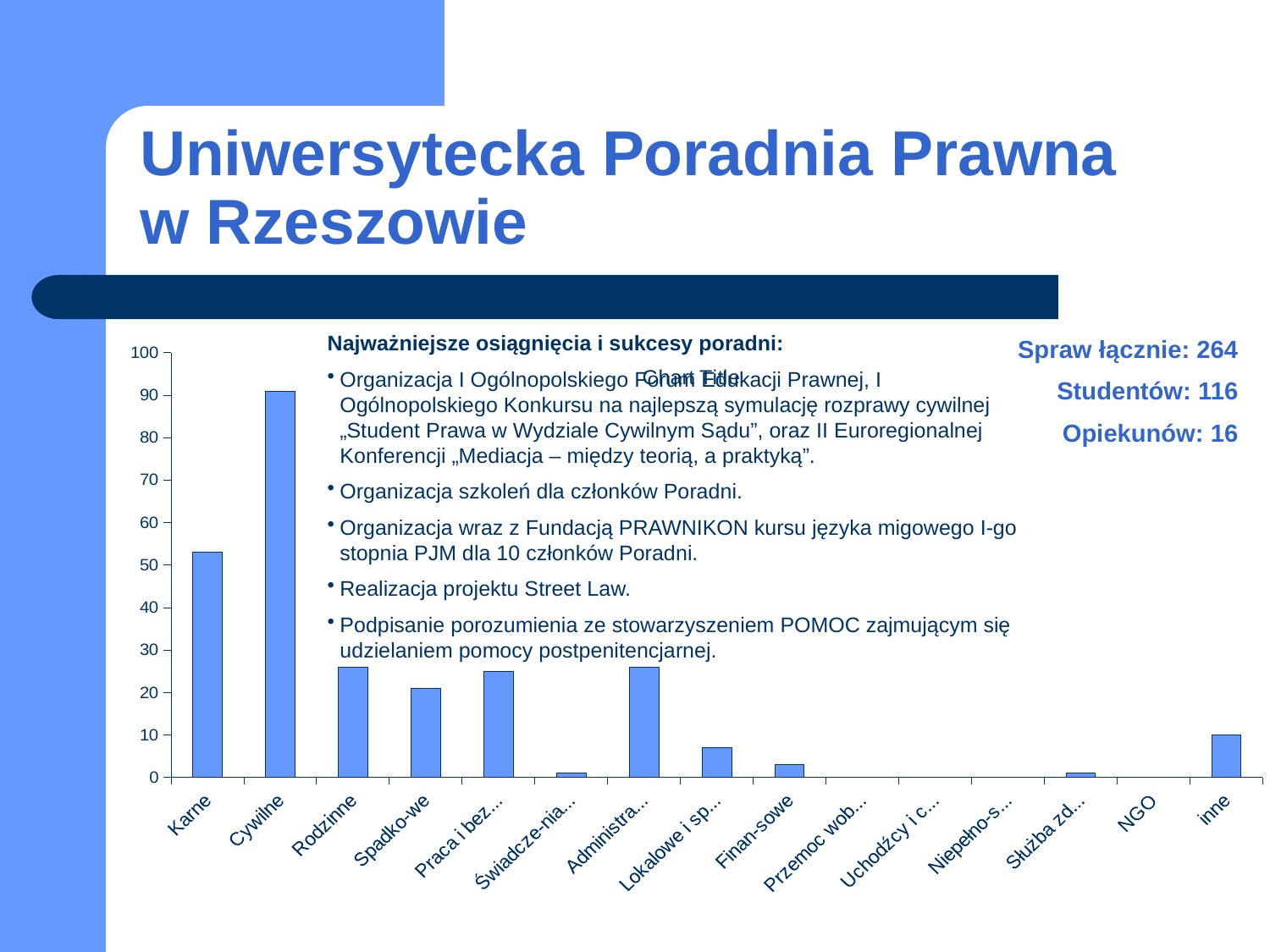
Which category has the highest bar in the chart? Cywilne What kind of chart is shown on the slide? bar chart How many categories are shown on the x axis of the chart? 15 What is the highest tick value shown on the vertical axis of the chart? 100 Is the value for Rodzinne greater or less than 20? greater Is the value for Spadko-we greater or less than 30? less Which is larger, the value for Karne or the value for Rodzinne? Karne Is the value for Karne greater or less than 40? greater Which is larger, the value for Cywilne or the value for Karne? Cywilne